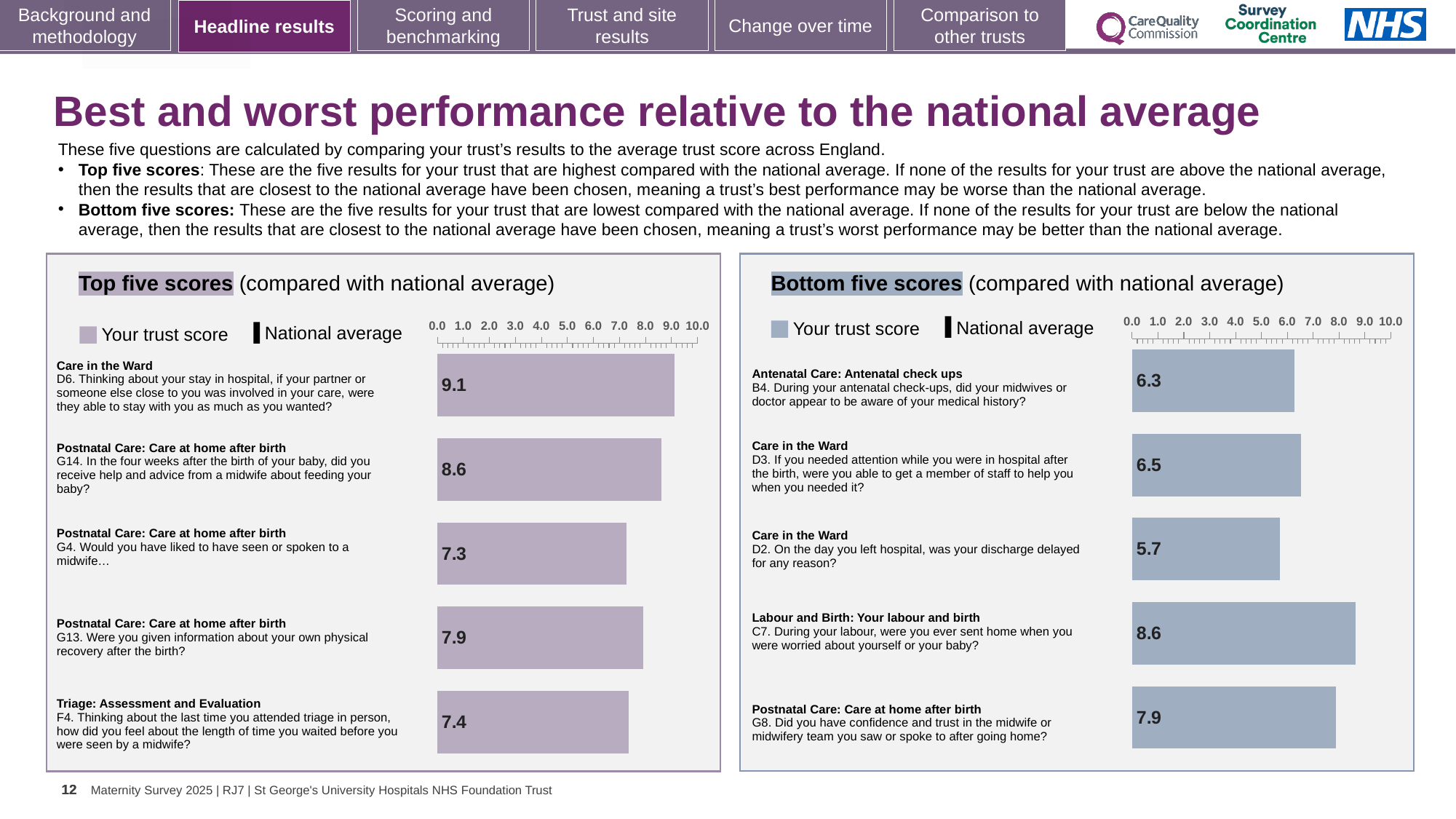
In the 'Bottom five scores' chart, which question has the lowest trust score? D2 (Care in the Ward) In the 'Top five scores' chart, is the trust score for G14 greater or less than 8.0? greater In the 'Top five scores' chart, what is the trust score for question F4 (Triage: Assessment and Evaluation)? 7.4 In the 'Bottom five scores' chart, what is the trust score for question D2 about discharge being delayed? 5.7 What type of chart is used in the 'Bottom five scores' panel? Bar chart In the 'Top five scores' chart, what is the difference between the scores for D6 and G4? 1.8 In the 'Bottom five scores' chart, which has the larger trust score, C7 or G8? C7 How many questions are plotted in the 'Top five scores' chart? 5 In the 'Top five scores' chart, what is the trust score for question D6 (Care in the Ward)? 9.1 In the 'Bottom five scores' chart, which question has the highest trust score? C7 (Labour and Birth: Your labour and birth) In the 'Top five scores' chart, which question has the highest trust score? D6 (Care in the Ward) In the 'Bottom five scores' chart, what is the difference between the scores for C7 and B4? 2.3